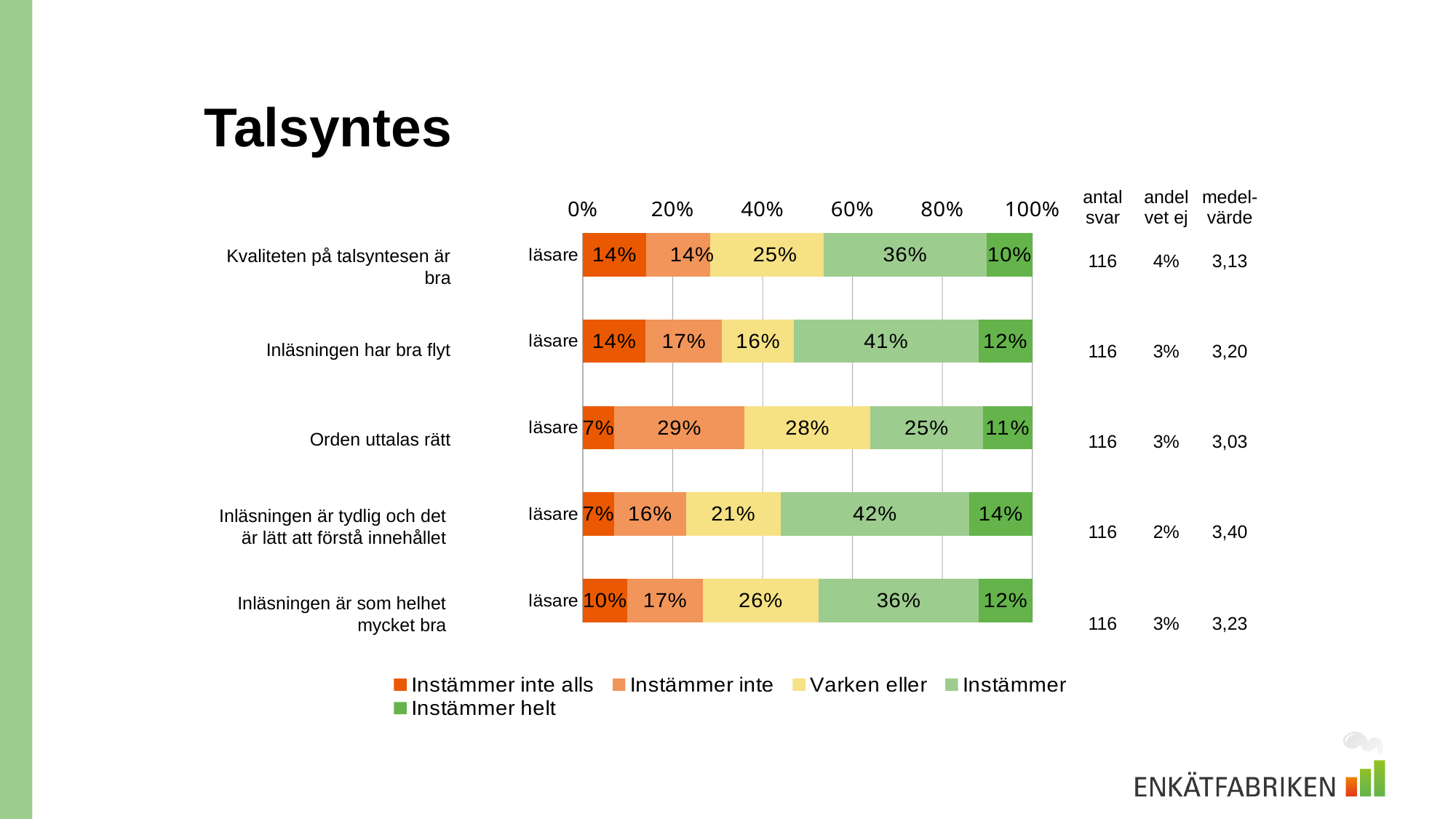
Which statement has the lowest "Instämmer helt" share? Kvaliteten på talsyntesen är bra What percentage of readers answered "Instämmer" for "Inläsningen har bra flyt"? 41% What is the "Instämmer inte" value for "Orden uttalas rätt"? 29% What kind of chart is shown on the slide? Stacked bar chart Which is larger: the "Instämmer" value for "Inläsningen har bra flyt" or for "Orden uttalas rätt"? Inläsningen har bra flyt How many series does the legend list? 5 What is the "Varken eller" value for "Inläsningen är som helhet mycket bra"? 26% Which statement has the highest "Instämmer" share? Inläsningen är tydlig och det är lätt att förstå innehållet How many statements (bars) are shown in the chart? 5 What is the "Instämmer helt" value for "Inläsningen är tydlig och det är lätt att förstå innehållet"? 14% What is the difference in percentage points between the "Instämmer" value for "Inläsningen är tydlig och det är lätt att förstå innehållet" and for "Orden uttalas rätt"? 17 percentage points Which statement has the highest "Instämmer inte" share? Orden uttalas rätt